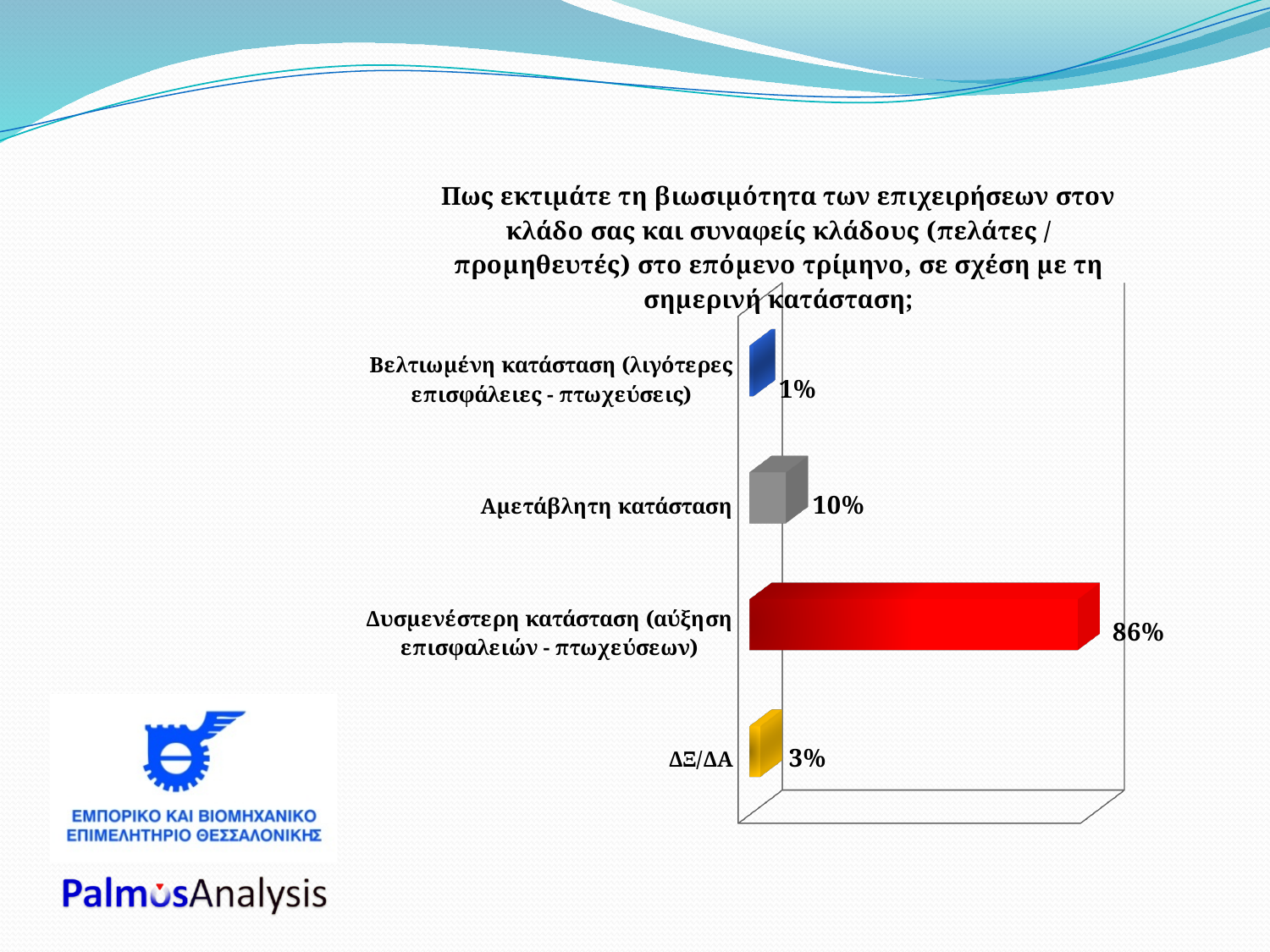
How many categories are shown in the chart? 4 Which is larger, the value for Αμετάβλητη κατάσταση or the value for ΔΞ/ΔΑ? Αμετάβλητη κατάσταση What percentage of respondents expect a worse situation (Δυσμενέστερη κατάσταση)? 86% What is the difference in percentage points between ΔΞ/ΔΑ and Βελτιωμένη κατάσταση? 2 What is the difference in percentage points between Δυσμενέστερη κατάσταση and Αμετάβλητη κατάσταση? 76 What colour is the bar for Δυσμενέστερη κατάσταση? Red What is the value shown for Αμετάβλητη κατάσταση? 10% What is the value shown for Βελτιωμένη κατάσταση (λιγότερες επισφάλειες - πτωχεύσεις)? 1% Which category has the lowest value? Βελτιωμένη κατάσταση (λιγότερες επισφάλειες - πτωχεύσεις) Which category has the highest value? Δυσμενέστερη κατάσταση (αύξηση επισφαλειών - πτωχεύσεων) What kind of chart is shown on the slide? Bar chart What percentage is shown for ΔΞ/ΔΑ? 3%